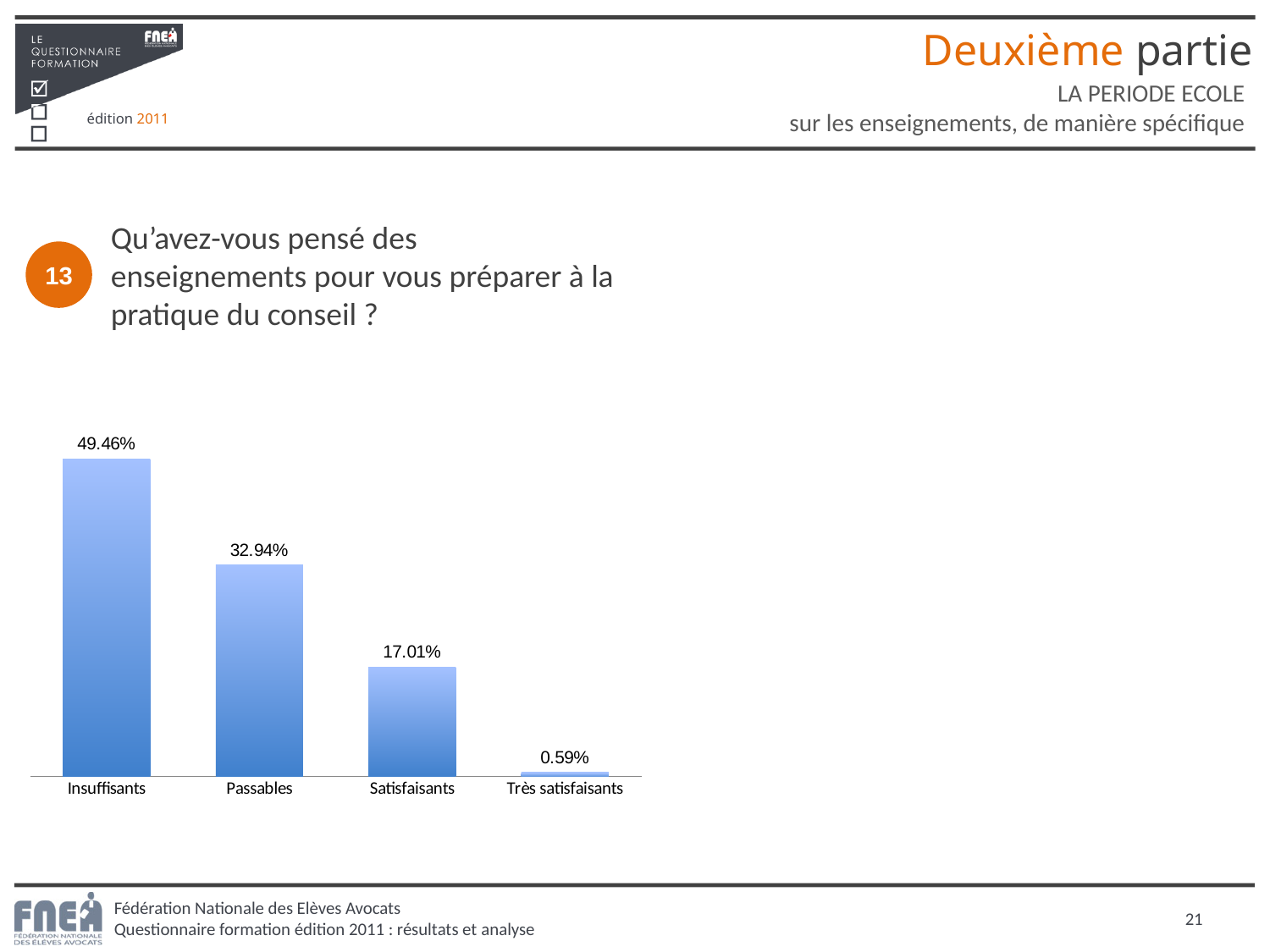
Which category has the highest value? Insuffisants How many categories are shown in the chart? 4 What is the value for Satisfaisants? 17.01% What is the value for Très satisfaisants? 0.59% What is the difference between the values for Insuffisants and Passables? 16.52% What kind of chart is shown on the slide? Bar chart What is the value for Passables? 32.94% What is the value for Insuffisants? 49.46% Which category has the lowest value? Très satisfaisants What is the difference between the values for Satisfaisants and Très satisfaisants? 16.42% Do the values rise or fall from left to right across the categories? Fall Which is larger, the value for Passables or the value for Satisfaisants? Passables